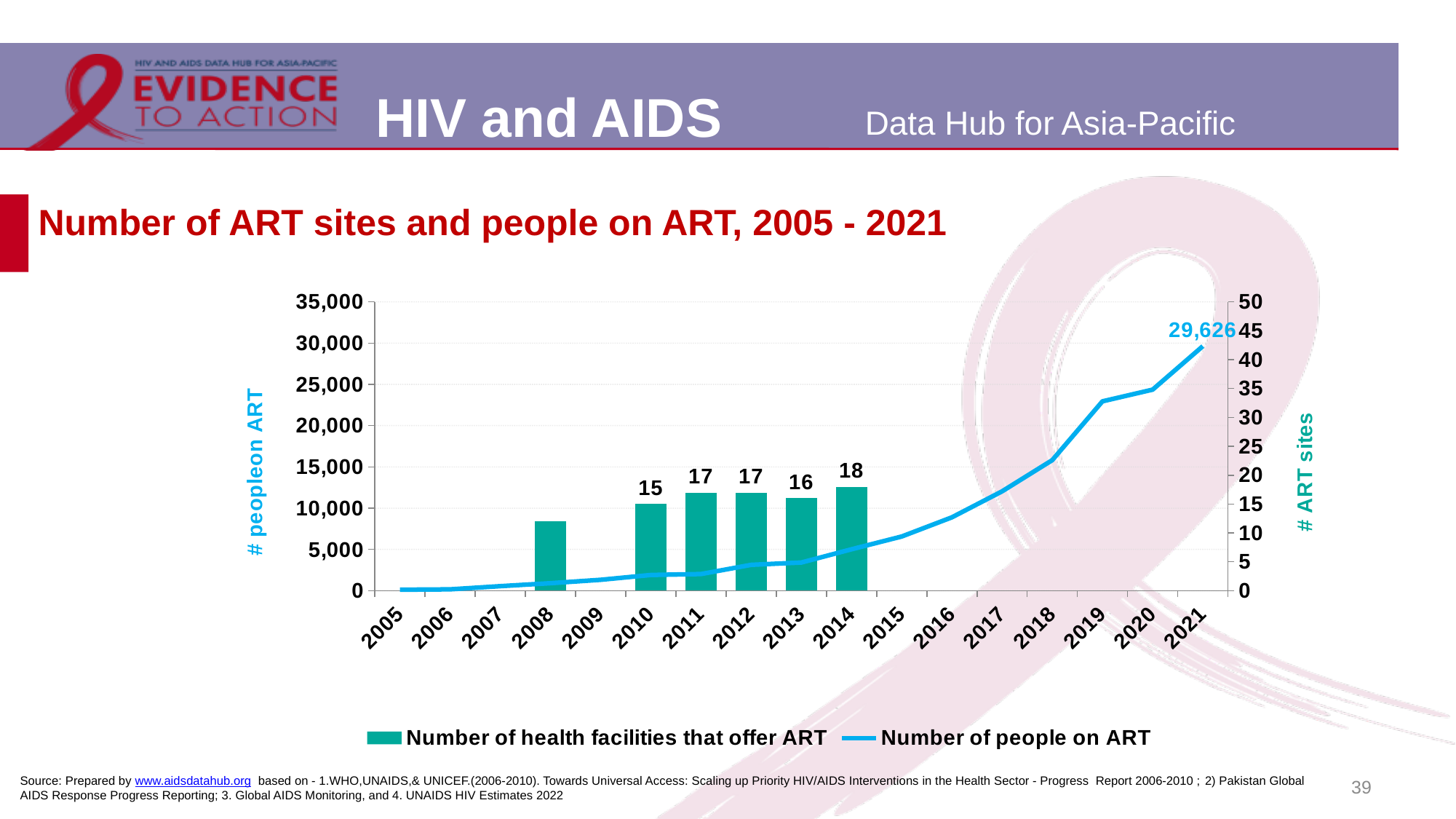
How many years are shown on the x axis? 17 How many series does the legend list? 2 Which year has the highest number of health facilities that offer ART? 2014 Which year has the lowest bar for number of health facilities that offer ART? 2008 Is the number of people on ART in 2016 greater or less than 10,000? less What was the number of people on ART in 2021? 29,626 How many health facilities offered ART in 2014? 18 Which year had more health facilities offering ART, 2012 or 2013? 2012 Does the number of people on ART rise or fall from 2005 to 2021? rise How many more health facilities offered ART in 2014 than in 2010? 3 What was the number of health facilities that offer ART in 2010? 15 Is the number of people on ART in 2019 greater or less than 20,000? greater